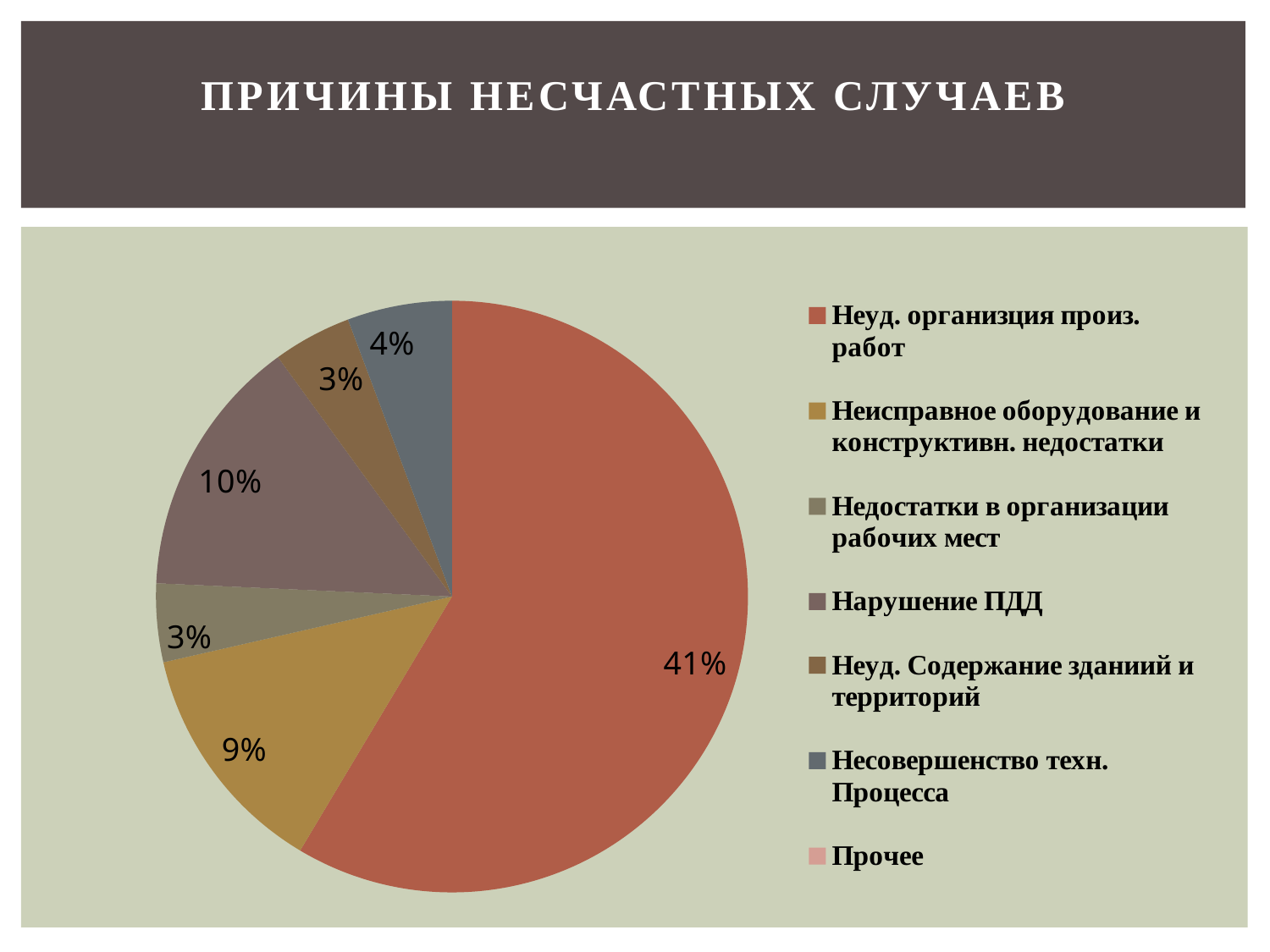
What percentage is shown for "Несовершенство техн. Процесса"? 4% How many entries does the legend list? 7 Which cause has the largest slice of the pie? Неуд. организция произ. работ What percentage is shown for "Неисправное оборудование и конструктивн. недостатки"? 9% What percentage is shown for "Неуд. организция произ. работ"? 41% What type of chart is shown on the slide? pie chart Which is larger: the slice for "Нарушение ПДД" or the slice for "Неисправное оборудование и конструктивн. недостатки"? Нарушение ПДД What percentage is shown for "Недостатки в организации рабочих мест"? 3% What is the title of the chart? ПРИЧИНЫ НЕСЧАСТНЫХ СЛУЧАЕВ What colour is the slice for "Неуд. организция произ. работ"? red What percentage is shown for "Нарушение ПДД"? 10% What is the difference in percentage points between "Неуд. организция произ. работ" and "Нарушение ПДД"? 31